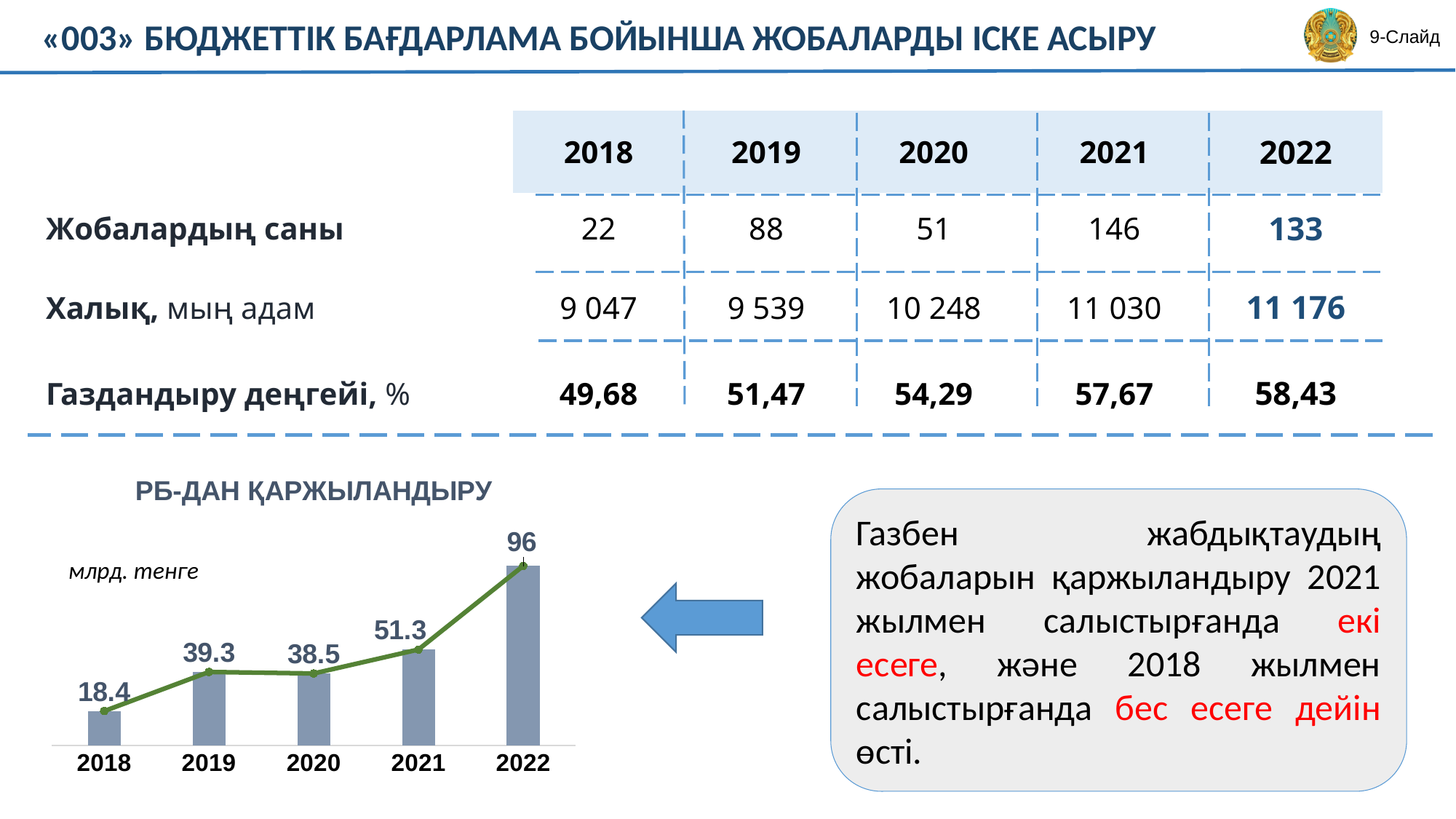
In the РБ-ДАН ҚАРЖЫЛАНДЫРУ chart, which is larger, the value for 2019 or the value for 2020? 2019 What unit is indicated on the РБ-ДАН ҚАРЖЫЛАНДЫРУ chart? млрд. тенге Which year has the lowest value in the РБ-ДАН ҚАРЖЫЛАНДЫРУ chart? 2018 How many years are shown on the x axis of the РБ-ДАН ҚАРЖЫЛАНДЫРУ chart? 5 What is the value for 2018 in the РБ-ДАН ҚАРЖЫЛАНДЫРУ chart? 18.4 Which year has the highest value in the РБ-ДАН ҚАРЖЫЛАНДЫРУ chart? 2022 Do the values in the РБ-ДАН ҚАРЖЫЛАНДЫРУ chart generally rise or fall from 2018 to 2022? Rise What is the value for 2020 in the РБ-ДАН ҚАРЖЫЛАНДЫРУ chart? 38.5 In the РБ-ДАН ҚАРЖЫЛАНДЫРУ chart, what is the difference between the 2019 and 2018 values? 20.9 What kind of chart is the РБ-ДАН ҚАРЖЫЛАНДЫРУ chart? Bar chart with a line overlay In the РБ-ДАН ҚАРЖЫЛАНДЫРУ chart, what is the difference between the 2022 and 2021 values? 44.7 What is the value for 2022 in the РБ-ДАН ҚАРЖЫЛАНДЫРУ chart? 96